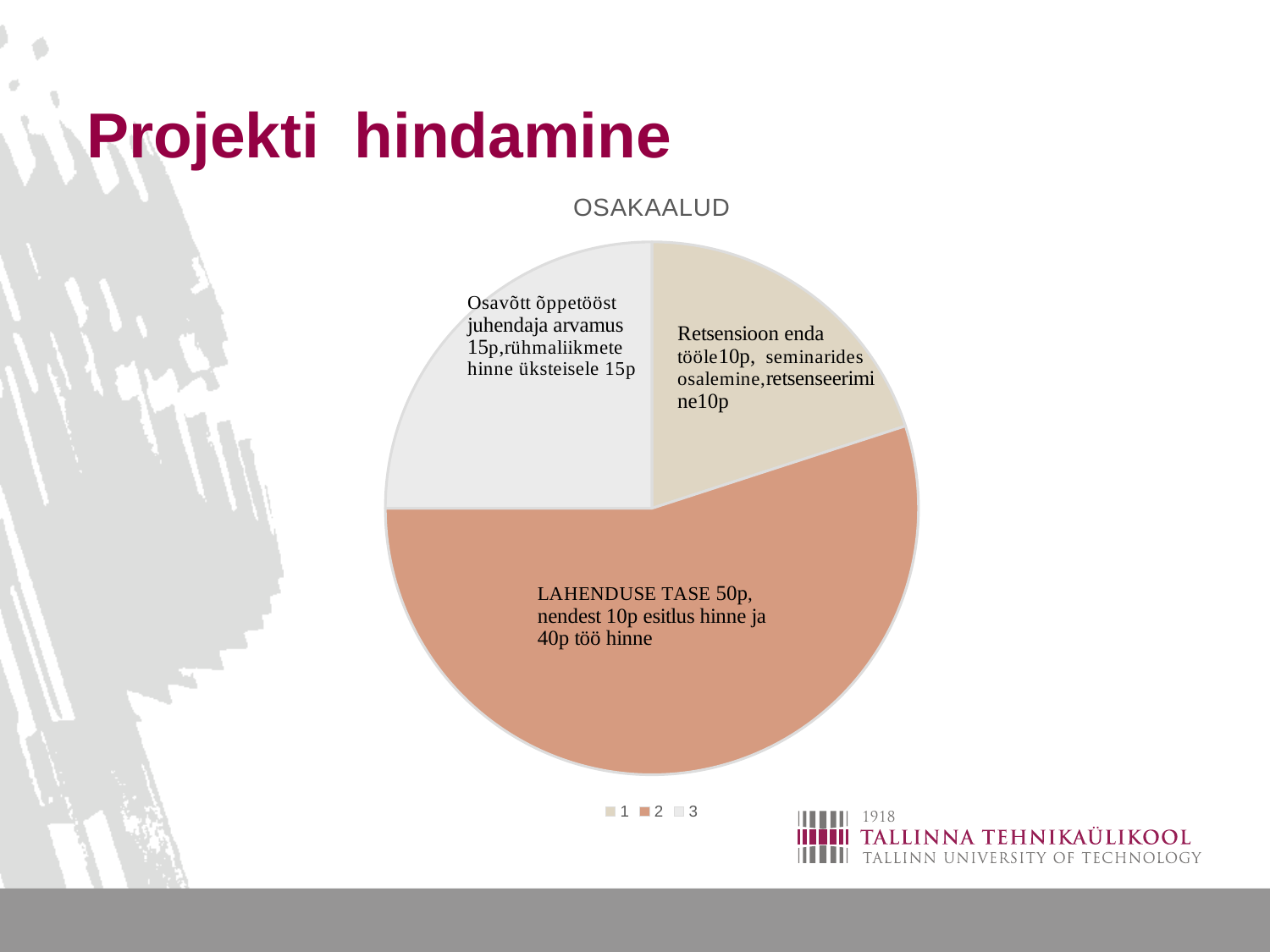
Of the LAHENDUSE TASE points, how many are for the work grade (töö hinne)? 40p What is the title of the chart? OSAKAALUD Which slice is larger, the one labelled 3 or the one labelled 1? 3 Which legend entry corresponds to the smallest slice of the pie? 1 What colour is the largest slice of the pie? salmon/orange-brown How many points is LAHENDUSE TASE worth according to the chart? 50p Which legend entry corresponds to the largest slice of the pie? 2 How many points is the supervisor's opinion (juhendaja arvamus) worth? 15p How many slices does the pie chart have? 3 How many entries does the chart legend list? 3 Which slice is larger, the one labelled 2 or the one labelled 3? 2 What kind of chart is shown on the slide? pie chart